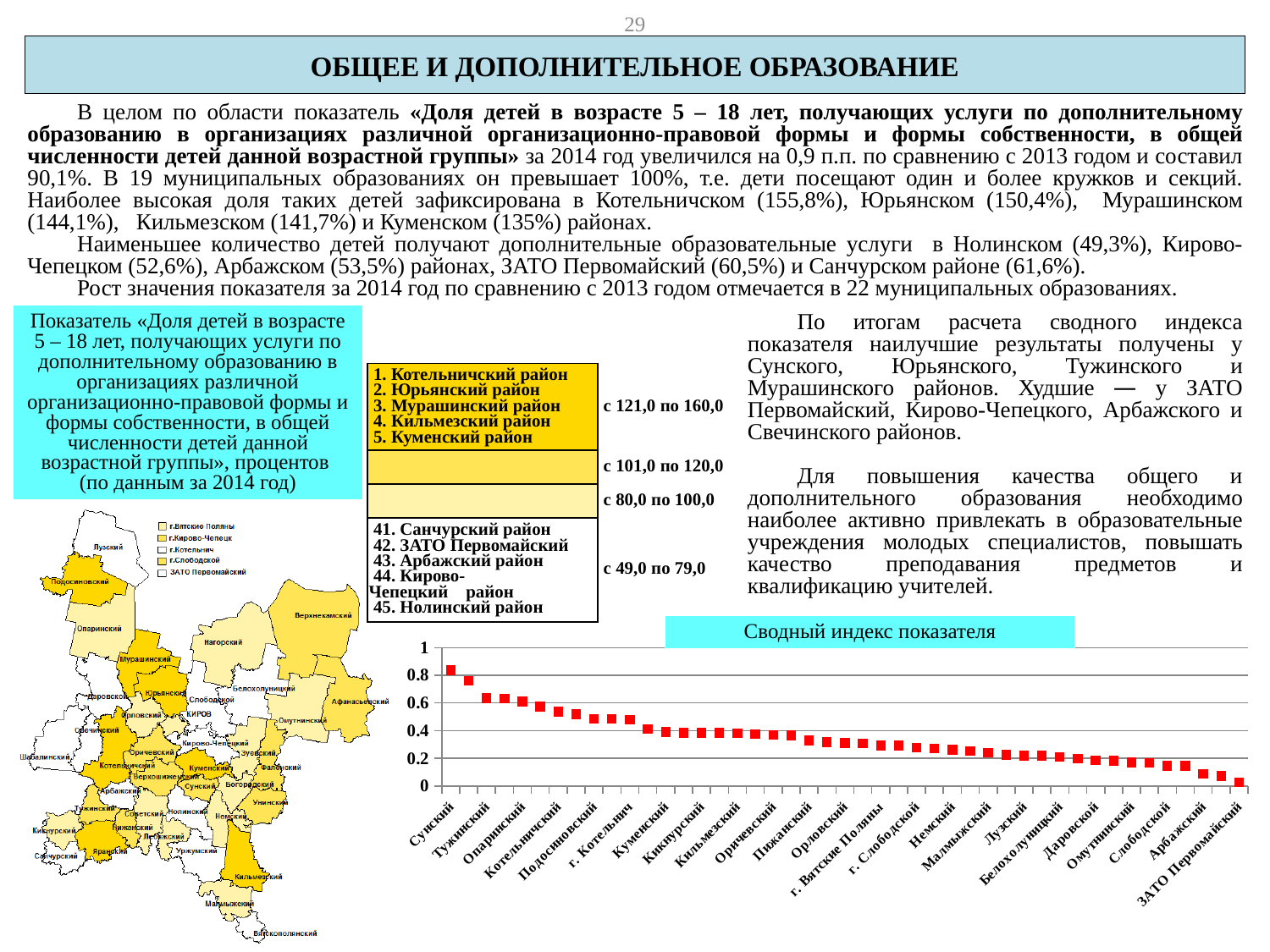
In the chart 'Сводный индекс показателя', is the value for ЗАТО Первомайский greater or less than 0.2? less In the chart 'Сводный индекс показателя', is the value for Сунский greater or less than 0.8? greater In the chart 'Сводный индекс показателя', which is larger, the value for Куменский or the value for Арбажский? Куменский In the chart 'Сводный индекс показателя', do the values rise or fall from left to right along the x axis? fall In the chart 'Сводный индекс показателя', is the value for Тужинский greater or less than 0.6? greater In the chart 'Сводный индекс показателя', which district has the lowest value? ЗАТО Первомайский In the chart 'Сводный индекс показателя', which is larger, the value for Сунский or the value for Тужинский? Сунский In the chart 'Сводный индекс показателя', which district has the highest value? Сунский What is the title of the chart at the bottom right of the slide? Сводный индекс показателя What colour are the data markers in the chart 'Сводный индекс показателя'? red